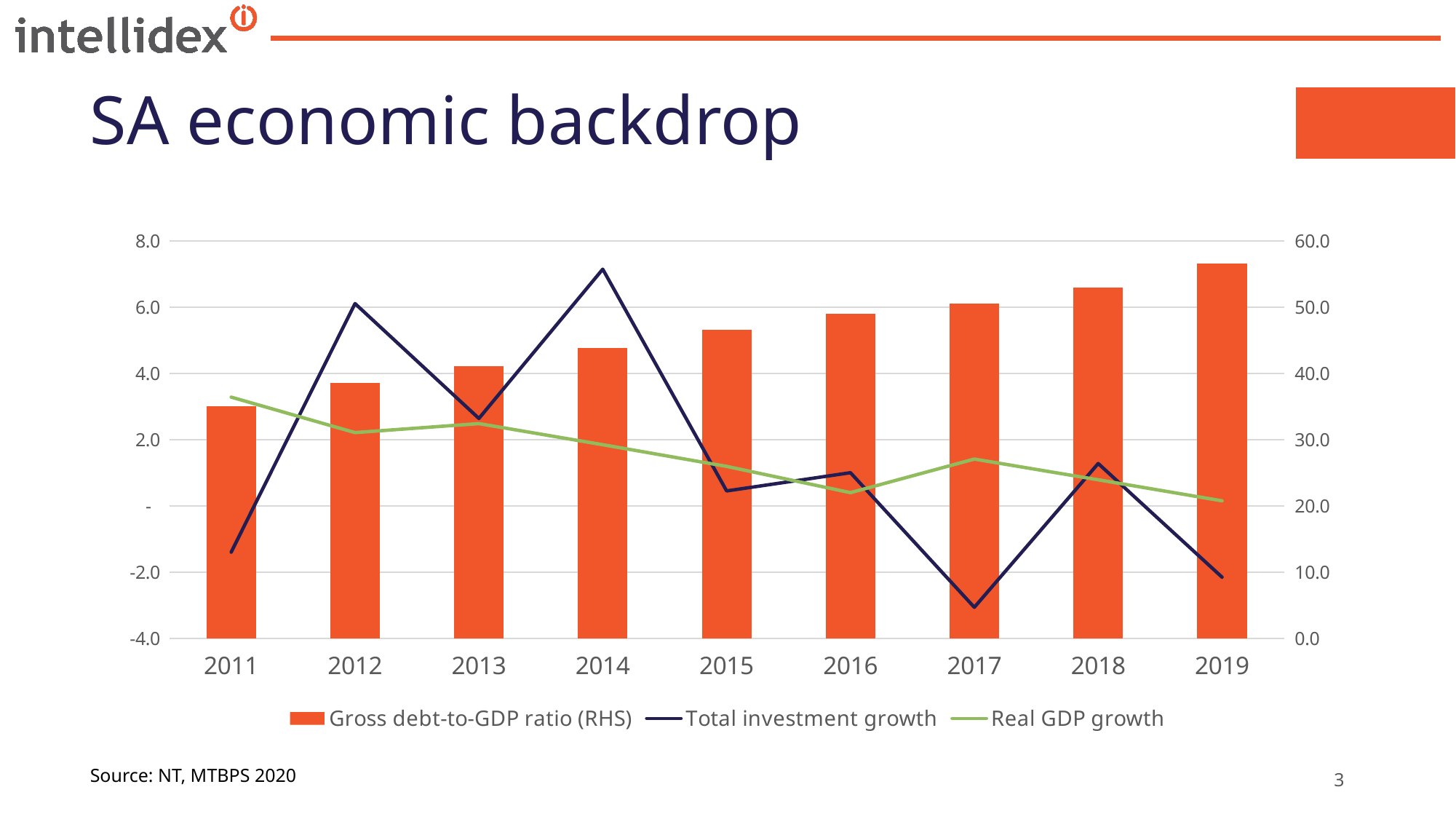
Do the gross debt-to-GDP ratio bars rise or fall from 2011 to 2019? Rise In which year is the gross debt-to-GDP ratio bar the highest? 2019 Is the gross debt-to-GDP ratio for 2019 greater or less than 50.0? greater Which series is plotted against the right-hand axis? Gross debt-to-GDP ratio (RHS) In which year is the gross debt-to-GDP ratio bar the lowest? 2011 How many series does the legend list? 3 In which year does total investment growth reach its lowest point? 2017 How many years are shown on the x axis? 9 What kind of chart is shown on the slide? A combination bar and line chart Is the gross debt-to-GDP ratio for 2011 greater or less than 40.0? less Which year has higher total investment growth, 2012 or 2013? 2012 In which year does total investment growth reach its highest point? 2014